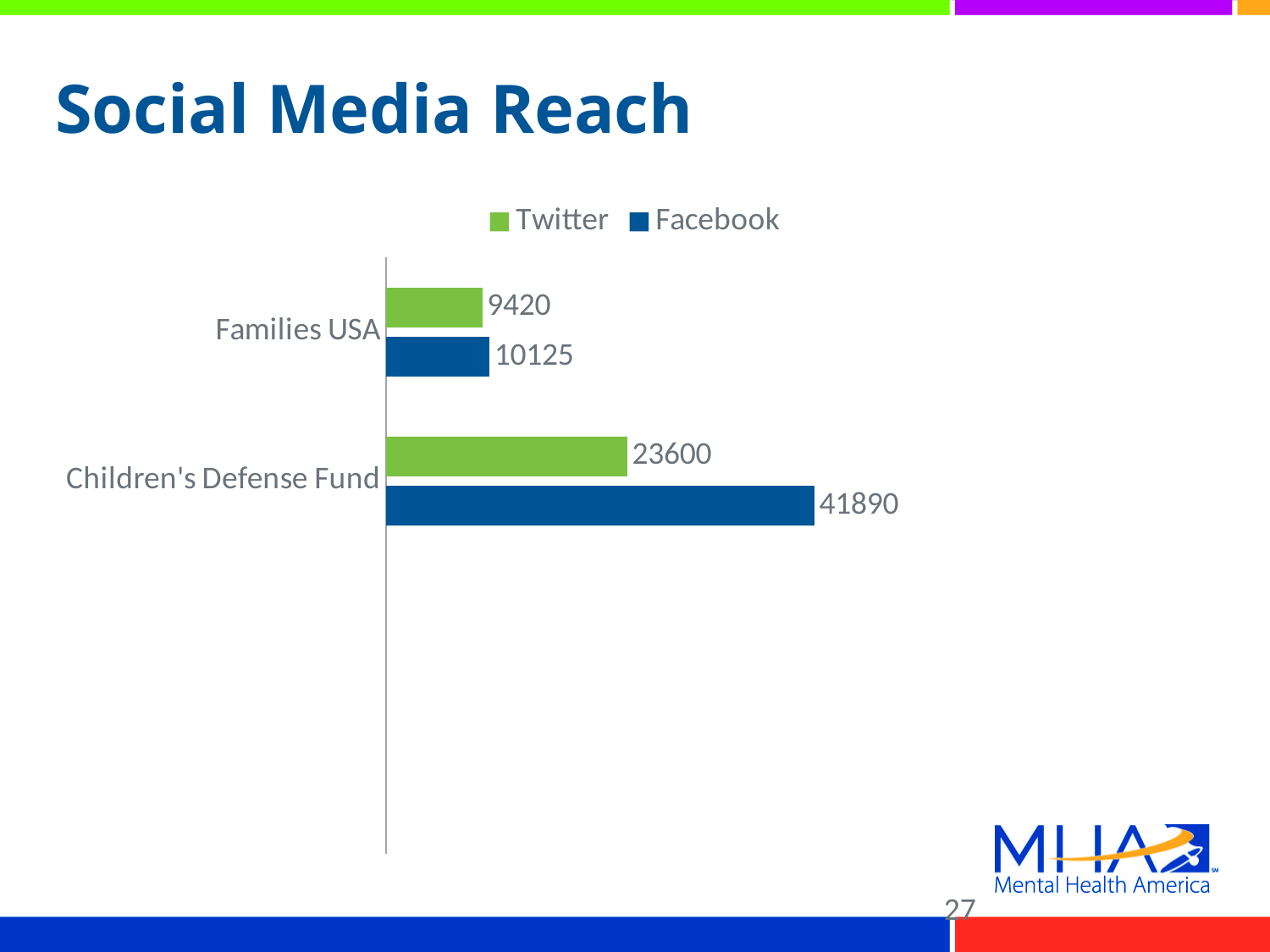
Which organization has the highest Facebook value? Children's Defense Fund What is the difference between the Facebook and Twitter values for Children's Defense Fund? 18290 What kind of chart is shown on the slide? Bar chart Which is larger for Families USA, the Twitter value or the Facebook value? Facebook How many organizations are shown on the chart? 2 What is the Twitter value for Families USA? 9420 What is the difference between the Facebook values for Children's Defense Fund and Families USA? 31765 Which organization has the lowest Twitter value? Families USA How many series does the legend list? 2 What is the Facebook value for Children's Defense Fund? 41890 What is the Twitter value for Children's Defense Fund? 23600 What is the Facebook value for Families USA? 10125